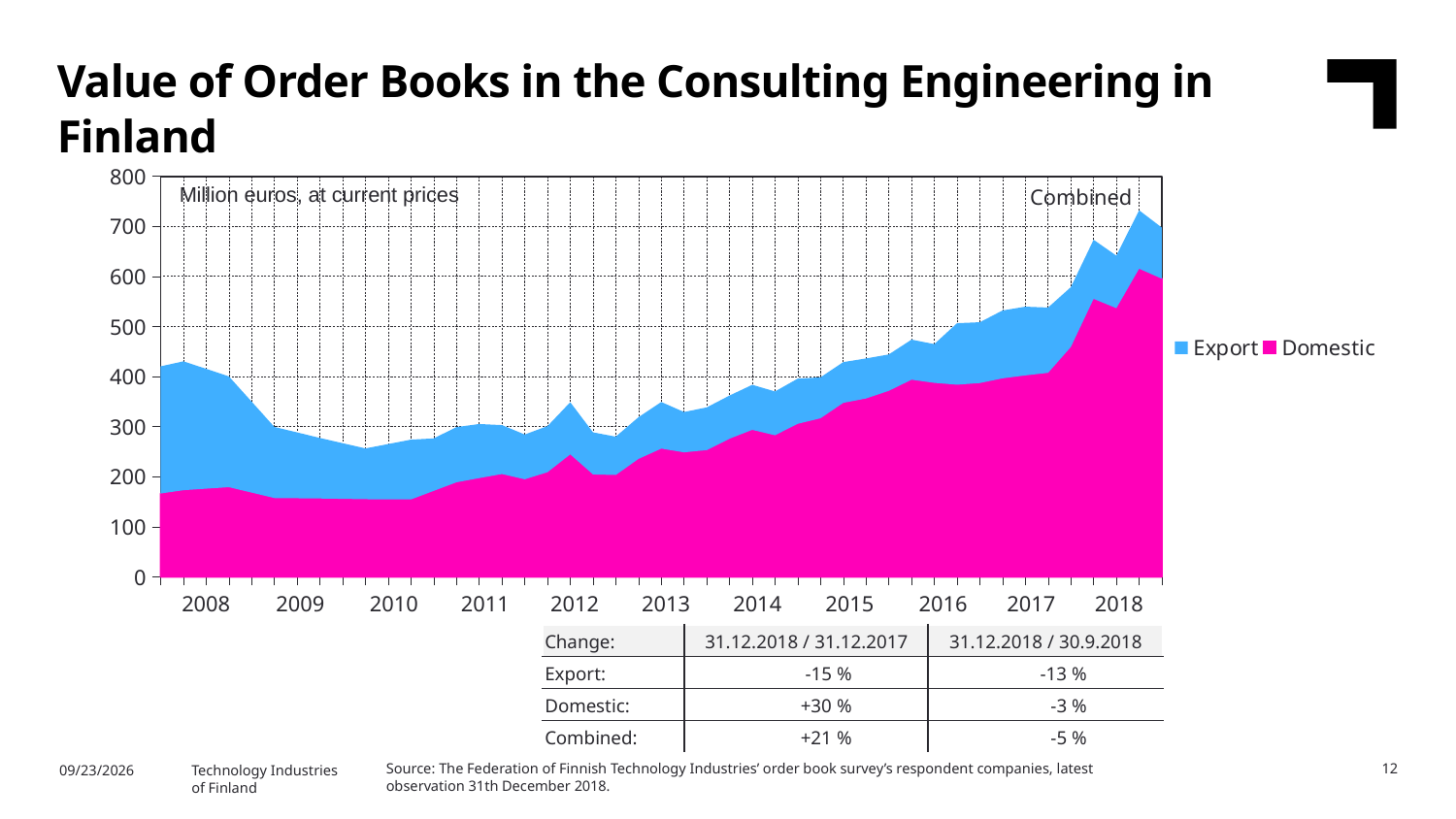
Is the combined value at the start of 2010 greater or less than 300? less How many years are labelled on the x axis of the chart? 11 Which two series are listed in the chart legend? Export and Domestic What unit is stated in the chart's annotation? Million euros, at current prices Is the combined value at the start of 2008 greater or less than 400? greater Does the combined value rise or fall between 2008 and 2010? fall What kind of chart is shown on the slide? Stacked area chart Does the Domestic series generally rise or fall from 2008 to 2018? rise Is the Domestic value at the start of 2008 greater or less than 200? less How many series does the chart legend list? 2